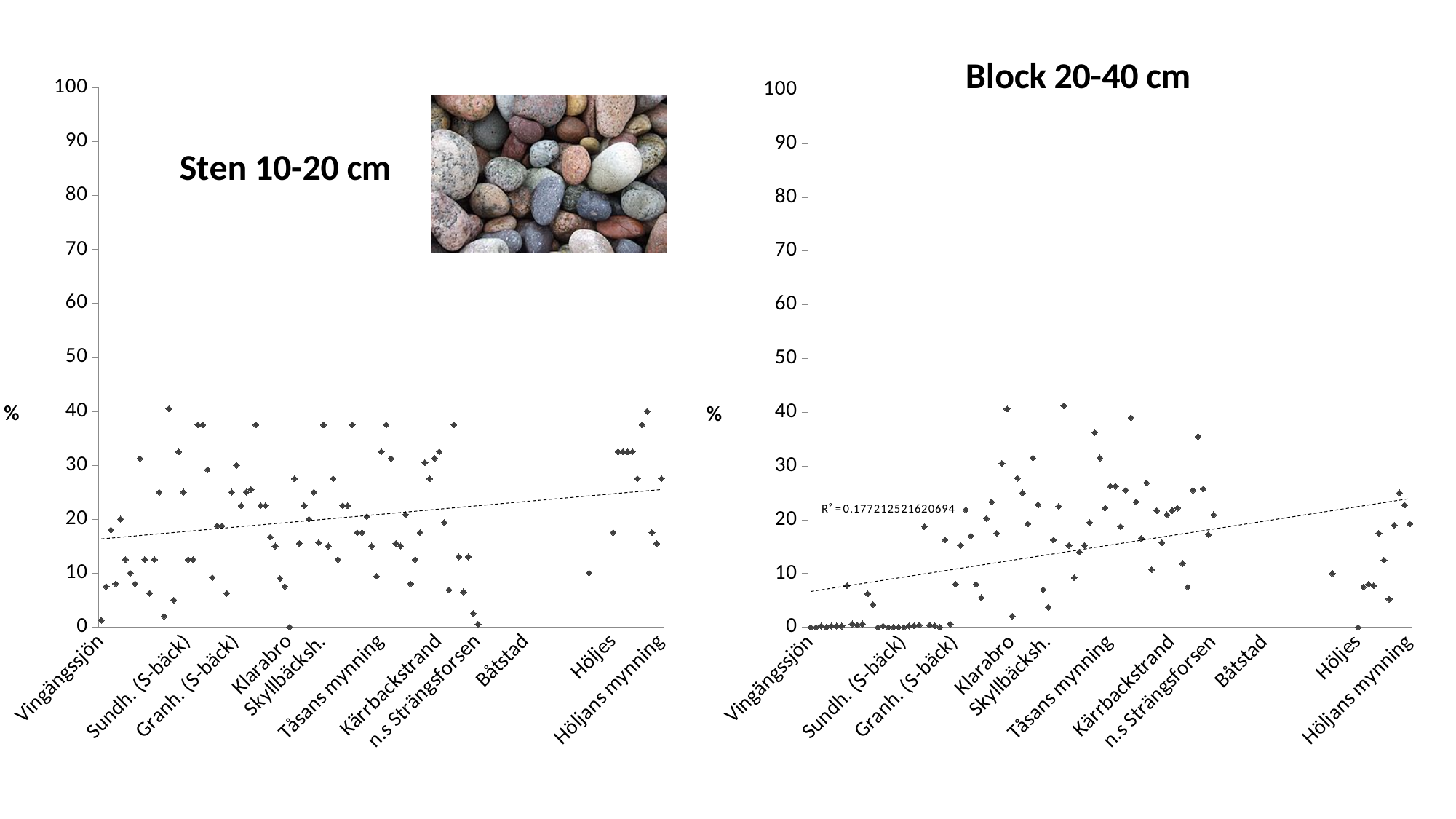
What is the label on the y axis of the 'Sten 10-20 cm' chart? % What is the maximum value shown on the y axis of the 'Block 20-40 cm' chart? 100 In the 'Sten 10-20 cm' chart, is the highest plotted point greater or less than 50? less In the 'Block 20-40 cm' chart, is the highest plotted point greater or less than 50? less In the 'Sten 10-20 cm' chart, does the dashed trend line rise or fall from left to right? rise What R² value is printed on the 'Block 20-40 cm' chart? 0.177212521620694 In the 'Block 20-40 cm' chart, is the highest point for Vingängssjön greater or less than 10? less What kind of chart is the 'Block 20-40 cm' chart? scatter chart What kind of chart is the 'Sten 10-20 cm' chart? scatter chart In the 'Block 20-40 cm' chart, does the dashed trend line rise or fall from left to right? rise How many location labels are shown on the x axis of the 'Block 20-40 cm' chart? 11 How many location labels are shown on the x axis of the 'Sten 10-20 cm' chart? 11